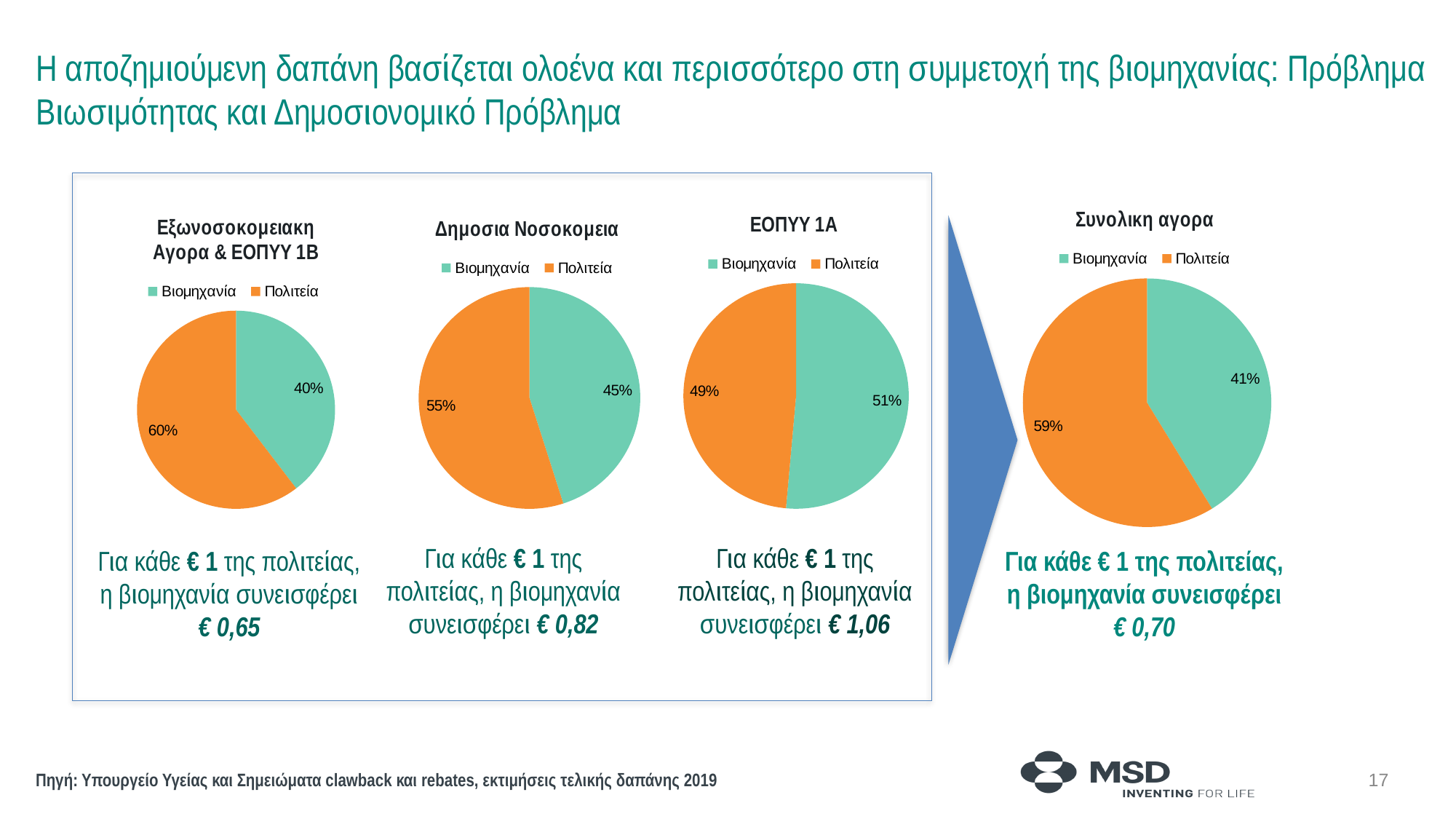
In the 'ΕΟΠΥΥ 1Α' pie chart, which slice is the largest? Βιομηχανία In the 'Δημοσια Νοσοκομεια' pie chart, what share does Πολιτεία have? 55% In the 'Εξωνοσοκομειακη Αγορα & ΕΟΠΥΥ 1Β' pie chart, what share does Βιομηχανία have? 40% In the 'ΕΟΠΥΥ 1Α' pie chart, what share does Βιομηχανία have? 51% In the 'Δημοσια Νοσοκομεια' pie chart, what is the difference in percentage points between Πολιτεία and Βιομηχανία? 10 How many series does the legend of the 'ΕΟΠΥΥ 1Α' chart list? 2 In the 'Εξωνοσοκομειακη Αγορα & ΕΟΠΥΥ 1Β' pie chart, which slice is larger, Βιομηχανία or Πολιτεία? Πολιτεία What type of chart is used for 'Δημοσια Νοσοκομεια'? Pie chart How many pie charts are shown on the slide? 4 In the 'Συνολικη αγορα' pie chart, what is the difference in percentage points between Πολιτεία and Βιομηχανία? 18